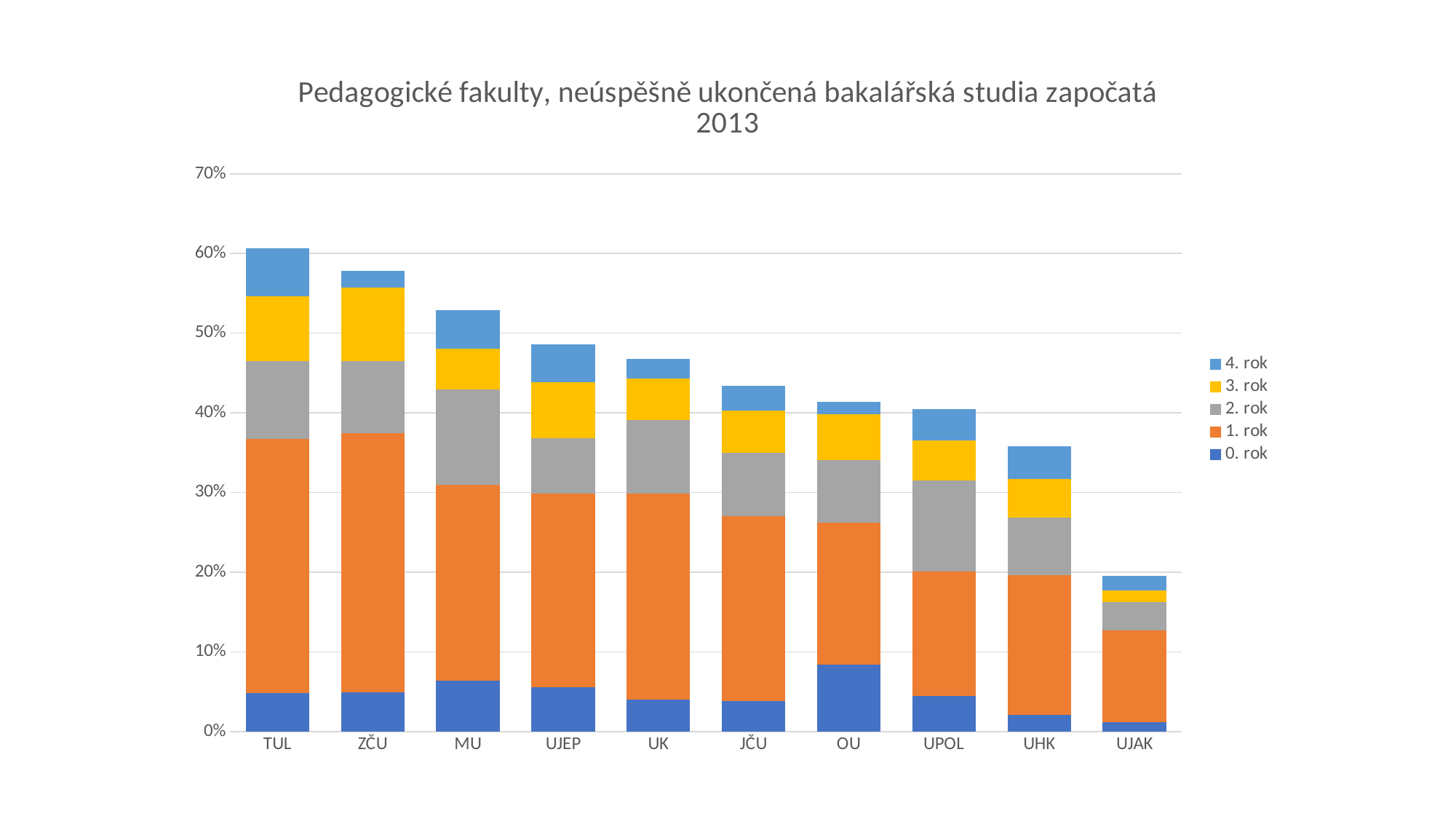
What kind of chart is shown on the slide? stacked bar chart Which faculty has the lowest total stacked bar? UJAK Is the total value for TUL greater or less than 50%? greater Which series is shown in orange in the legend? 1. rok Is the total value for UHK greater or less than 40%? less Is the 0. rok value for OU greater or less than 5%? greater How many series does the legend list? 5 Which faculty has the largest 0. rok segment? OU How many faculties (categories) are shown on the x axis? 10 Which faculty has the highest total stacked bar? TUL Do the total bar heights rise or fall from left to right along the x axis? fall